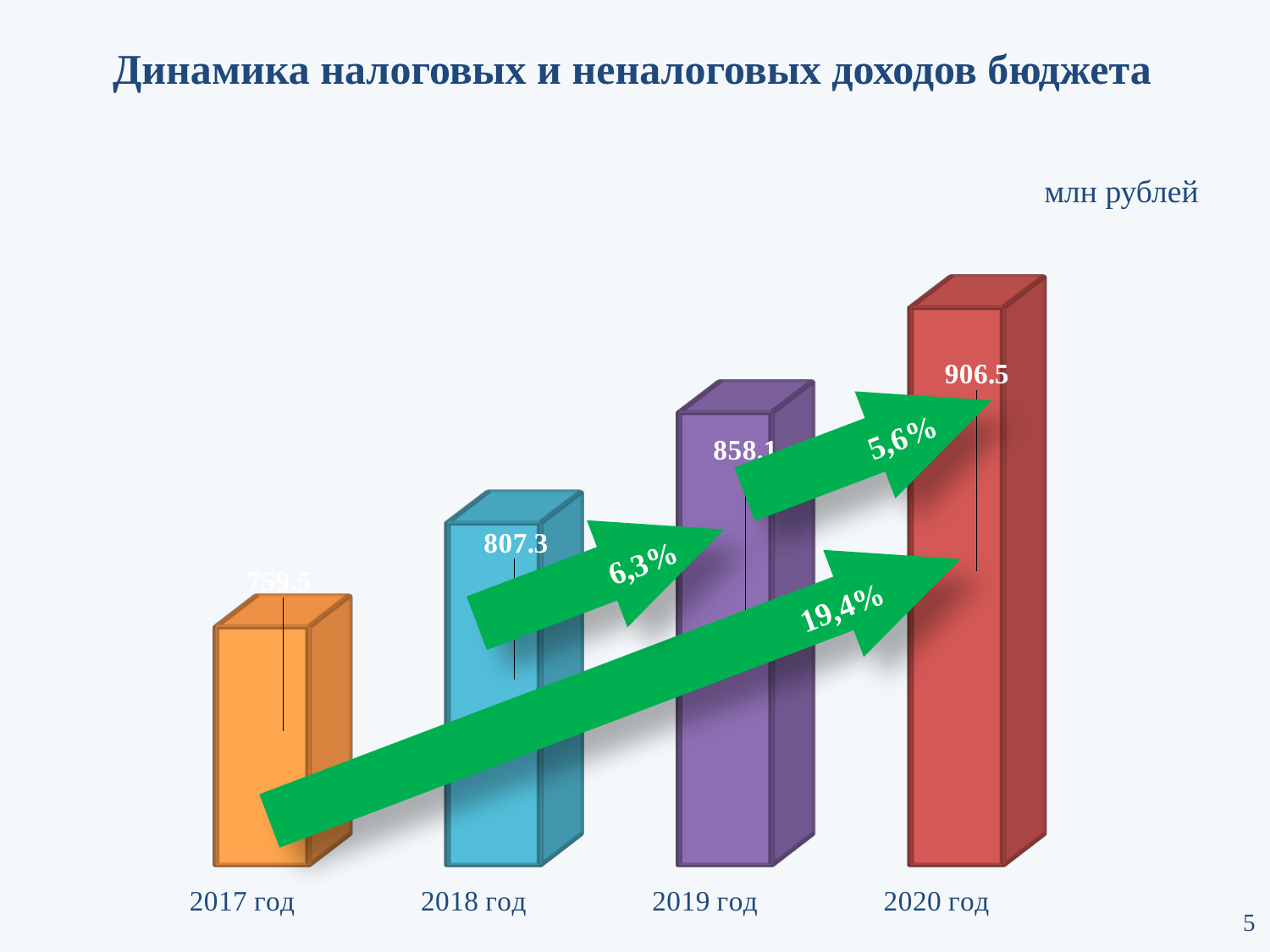
What is the value for 2018 год? 807.3 What is the value for 2017 год? 759.5 What kind of chart is shown on the slide? bar chart What is the difference between the values for 2020 год and 2017 год? 147.0 Which year has the highest value? 2020 год Which is larger, the value for 2018 год or the value for 2019 год? 2019 год What is the value for 2020 год? 906.5 Which year has the lowest value? 2017 год What is the value for 2019 год? 858.1 How many years are shown in the chart? 4 Do the values rise or fall from 2017 год to 2020 год? rise What is the difference between the values for 2019 год and 2018 год? 50.8